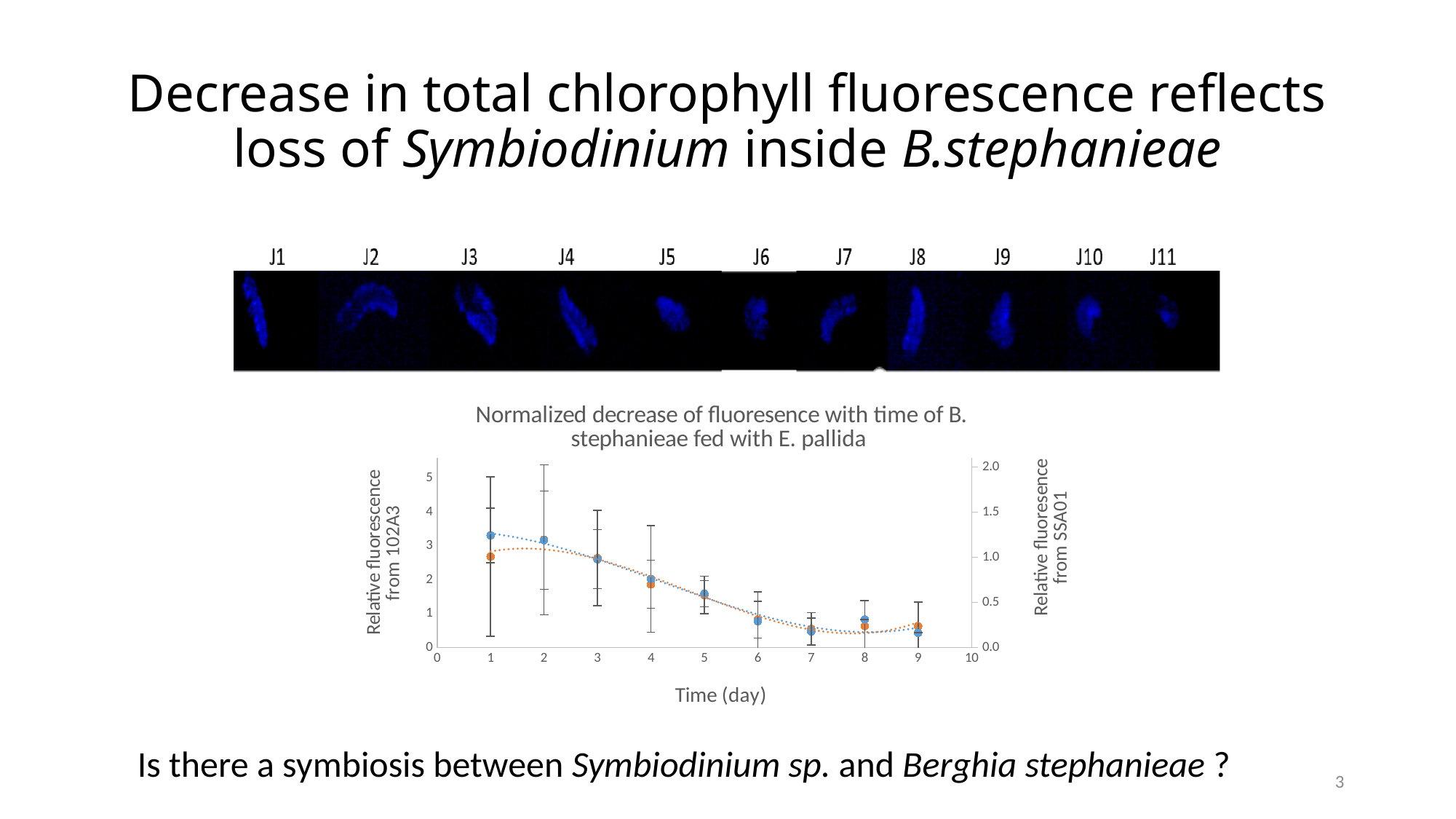
Do the plotted fluorescence values generally rise or fall as time increases along the x axis? fall On the left axis scale, is the blue series value at day 1 greater or less than 3? greater On the left axis scale, is the blue series value at day 3 greater or less than 2? greater On the left axis scale, is the blue series value at day 5 greater or less than 2? less What is the title of the chart? Normalized decrease of fluoresence with time of B. stephanieae fed with E. pallida What is the maximum value shown on the right-hand y axis of the chart? 2.0 How many time points (days) are plotted in the chart? 9 What is the label of the x axis of the chart? Time (day) What kind of chart is shown on the slide? scatter chart